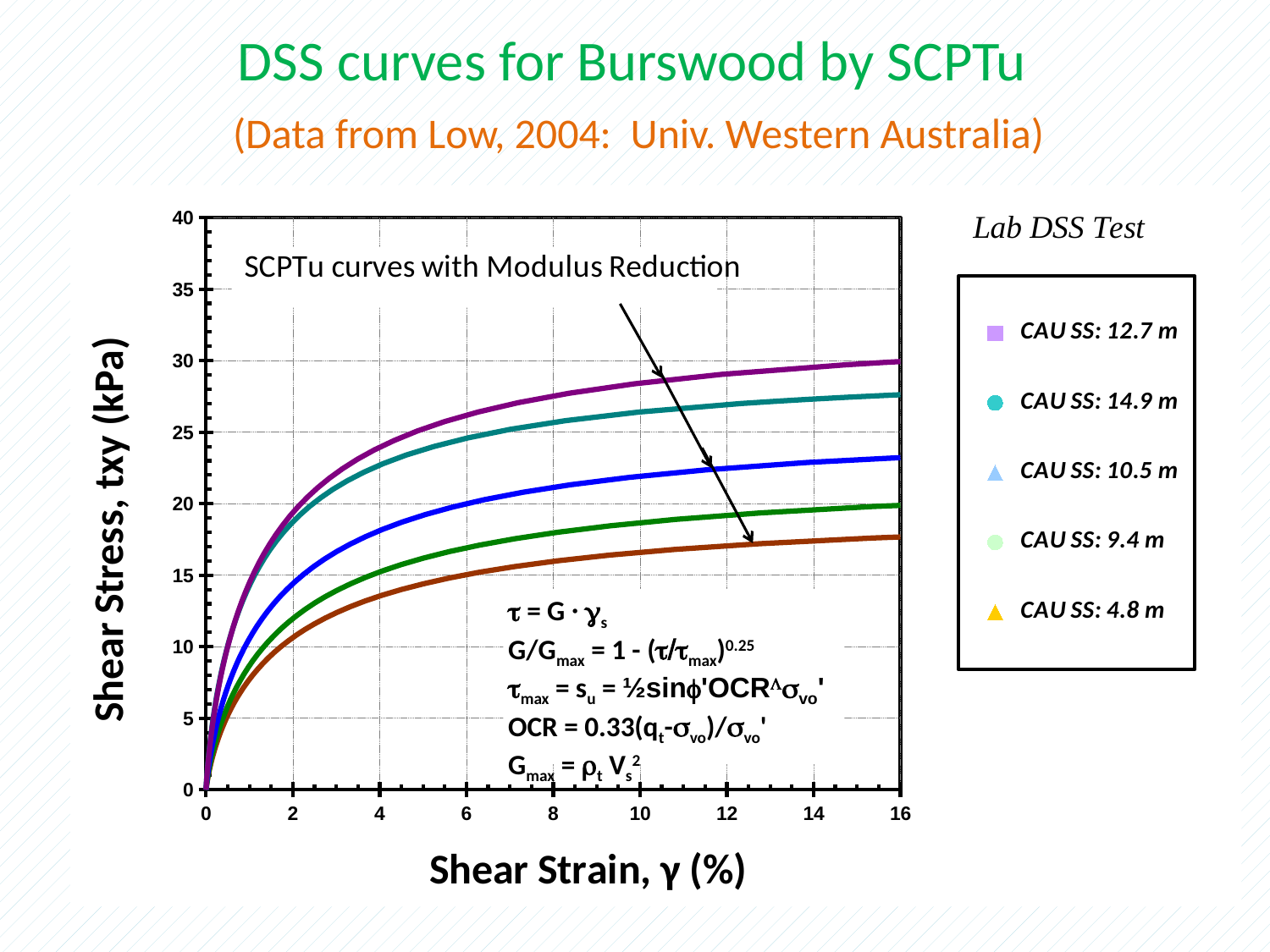
Is the shear stress of the teal curve at a shear strain of 16% greater or less than 25 kPa? greater How many entries does the legend list? 5 At a shear strain of 8%, which curve has the larger shear stress, the purple curve or the blue curve? the purple curve What kind of chart is shown on the slide? line chart Which curve reaches the highest shear stress at a shear strain of 16%? the purple curve Which curve has the lowest shear stress at a shear strain of 16%? the brown curve Is the shear stress of the brown curve at a shear strain of 16% greater or less than 20 kPa? less What is the label of the y axis? Shear Stress, txy (kPa) Is the shear stress of the blue curve at a shear strain of 16% greater or less than 20 kPa? greater How many curves are plotted on the chart? 5 Do the curves rise or fall as shear strain increases along the x axis? rise What is the label of the x axis? Shear Strain, γ (%)